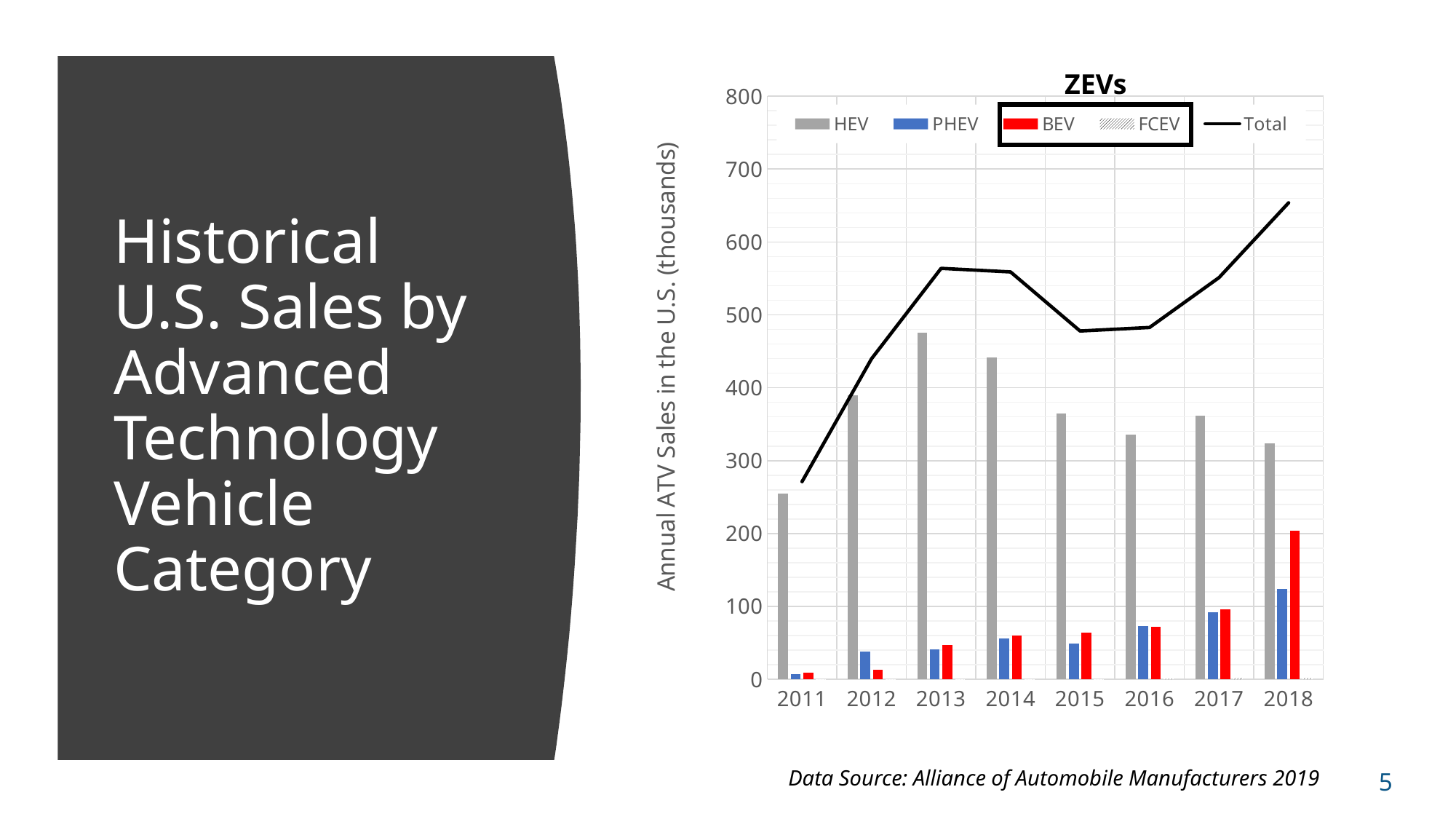
Is the BEV value for 2018 greater or less than 150? greater What is the label on the y axis? Annual ATV Sales in the U.S. (thousands) In which year are BEV sales highest? 2018 Does the Total line rise or fall from 2015 to 2018? rise In 2018, which is larger, BEV sales or PHEV sales? BEV How many series does the legend list? 5 How many years are shown on the x axis? 8 Is the Total value for 2018 greater or less than 600? greater Is the HEV value for 2011 greater or less than 300? less What kind of chart is shown on the slide? combination bar and line chart In which year are HEV sales highest? 2013 In which year are HEV sales lowest? 2011